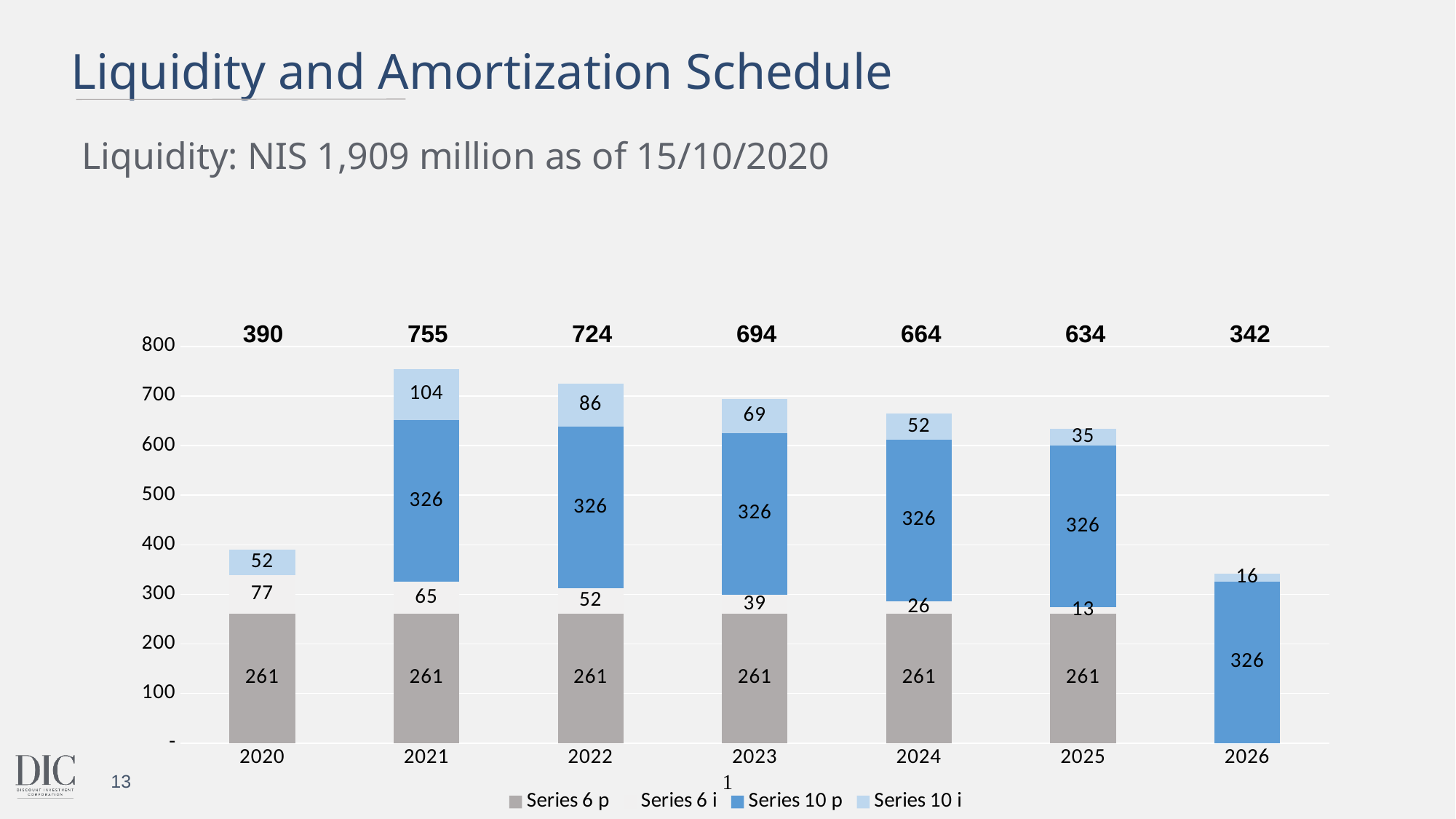
Which year has the highest total? 2021 What is the value of Series 6 p in 2024? 261 What kind of chart is shown? Stacked bar chart What is the total of the stacked bar for 2021? 755 What is the value of Series 10 i in 2022? 86 What is the value of Series 6 i in 2020? 77 Which is larger, the Series 10 i value in 2021 or in 2025? 2021 How many series does the legend list? 4 Which year has the lowest total? 2026 What is the difference between the totals for 2021 and 2026? 413 Do the totals rise or fall from 2021 to 2026? Fall How many years are shown on the x axis? 7